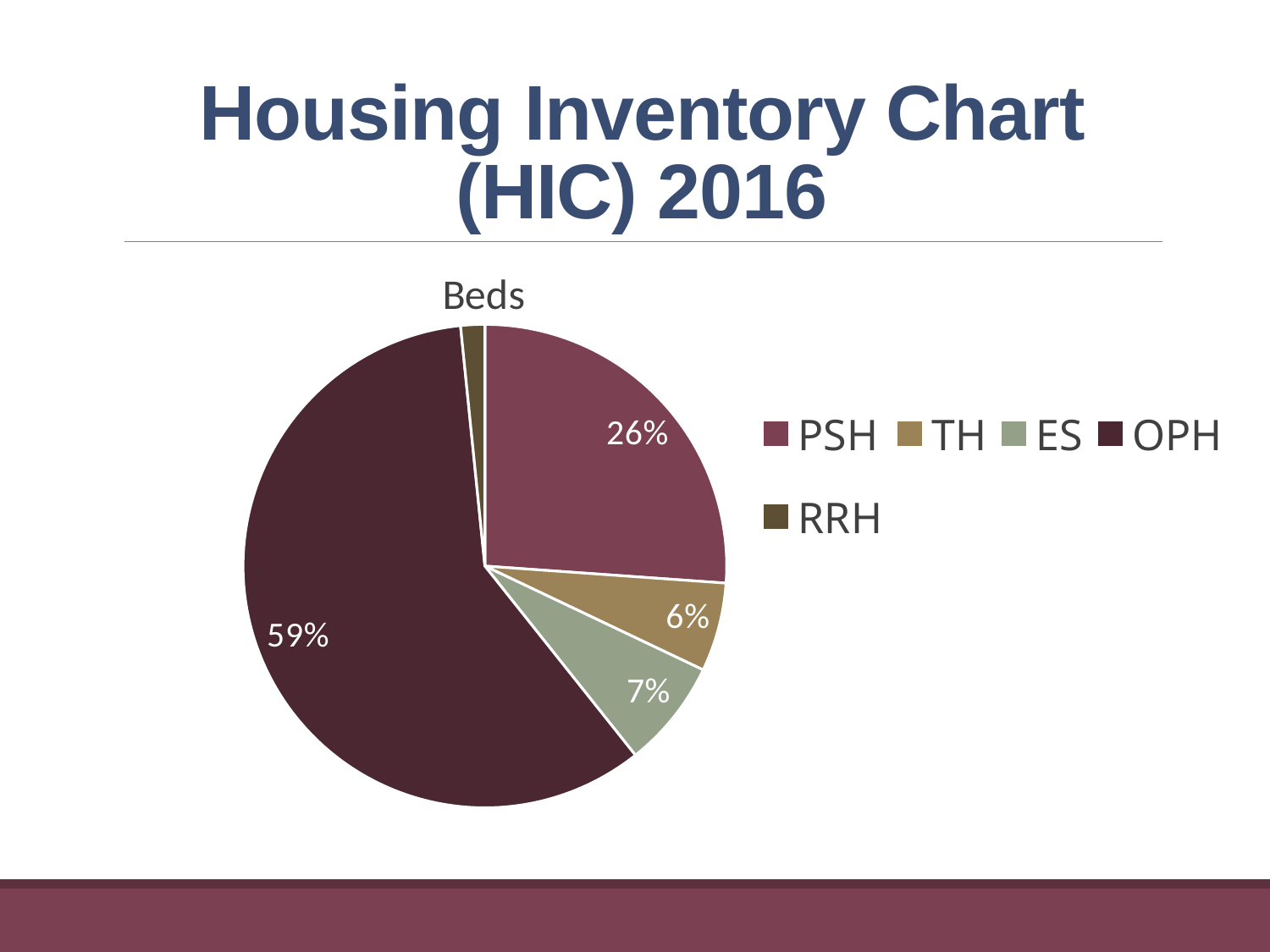
What percentage is shown for ES in the Beds pie chart? 7% What share of the Beds pie chart is OPH? 59% What type of chart is shown on the slide? Pie chart What percentage of beds is PSH in the pie chart? 26% What percentage is shown for TH in the Beds pie chart? 6% Which is larger in the Beds pie chart, PSH or OPH? OPH What is the title of the chart on the slide? Beds How many categories does the Beds pie chart have? 5 Which category has the largest slice of the Beds pie chart? OPH What is the difference in percentage points between OPH and PSH in the Beds pie chart? 33% Which category has the smallest slice of the Beds pie chart? RRH Which is larger in the Beds pie chart, ES or TH? ES